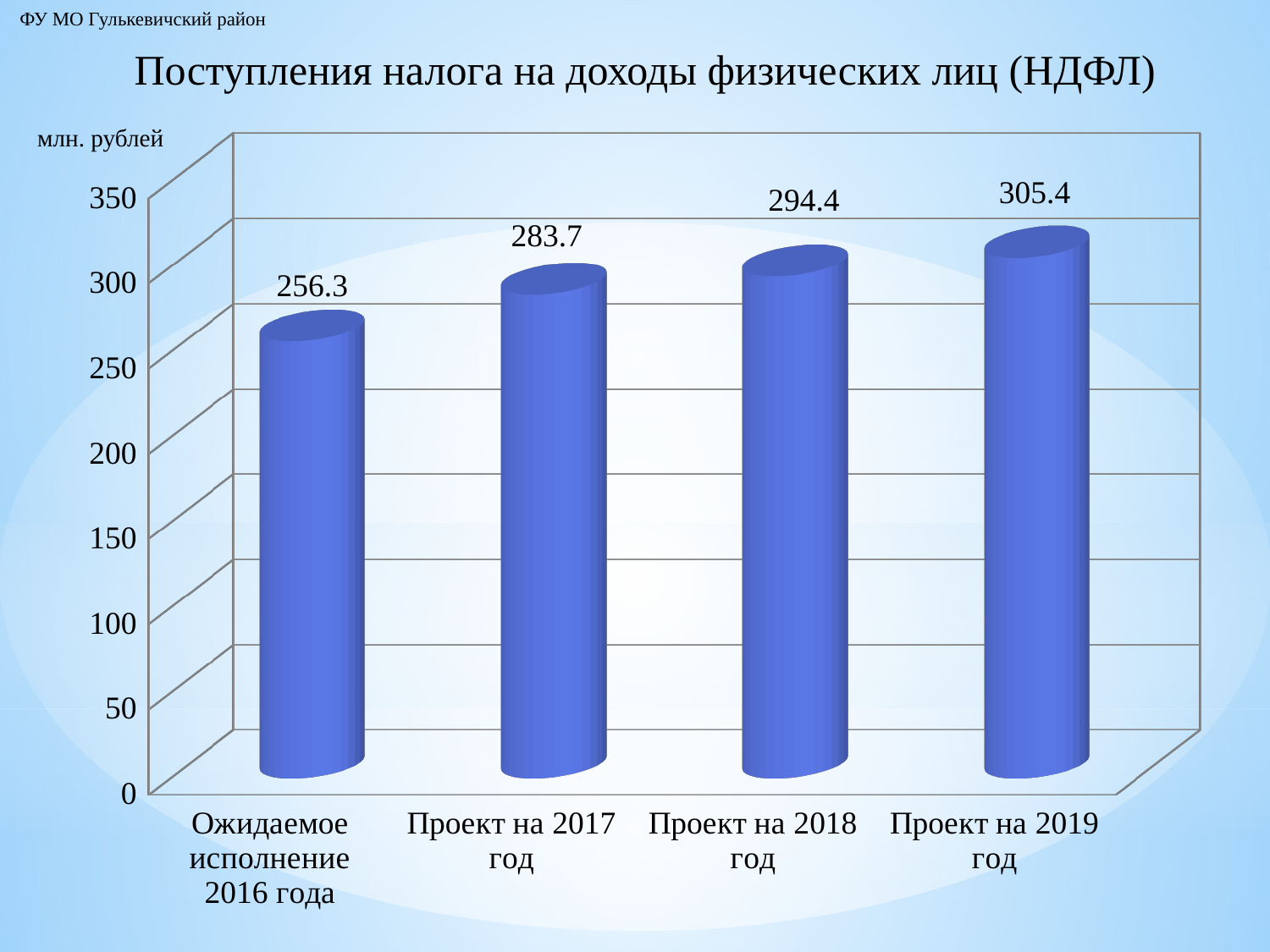
What is the value for Проект на 2017 год? 283.7 What kind of chart is shown on the slide? Bar chart Which category has the lowest value? Ожидаемое исполнение 2016 года What is the value for Проект на 2019 год? 305.4 How many categories are shown in the chart? 4 What is the difference between the values for Проект на 2019 год and Ожидаемое исполнение 2016 года? 49.1 What is the value for Ожидаемое исполнение 2016 года? 256.3 What is the value for Проект на 2018 год? 294.4 Which is larger, the value for Проект на 2017 год or Проект на 2018 год? Проект на 2018 год Which category has the highest value? Проект на 2019 год What is the difference between the values for Проект на 2018 год and Проект на 2017 год? 10.7 Do the values rise or fall from left to right along the x axis? Rise